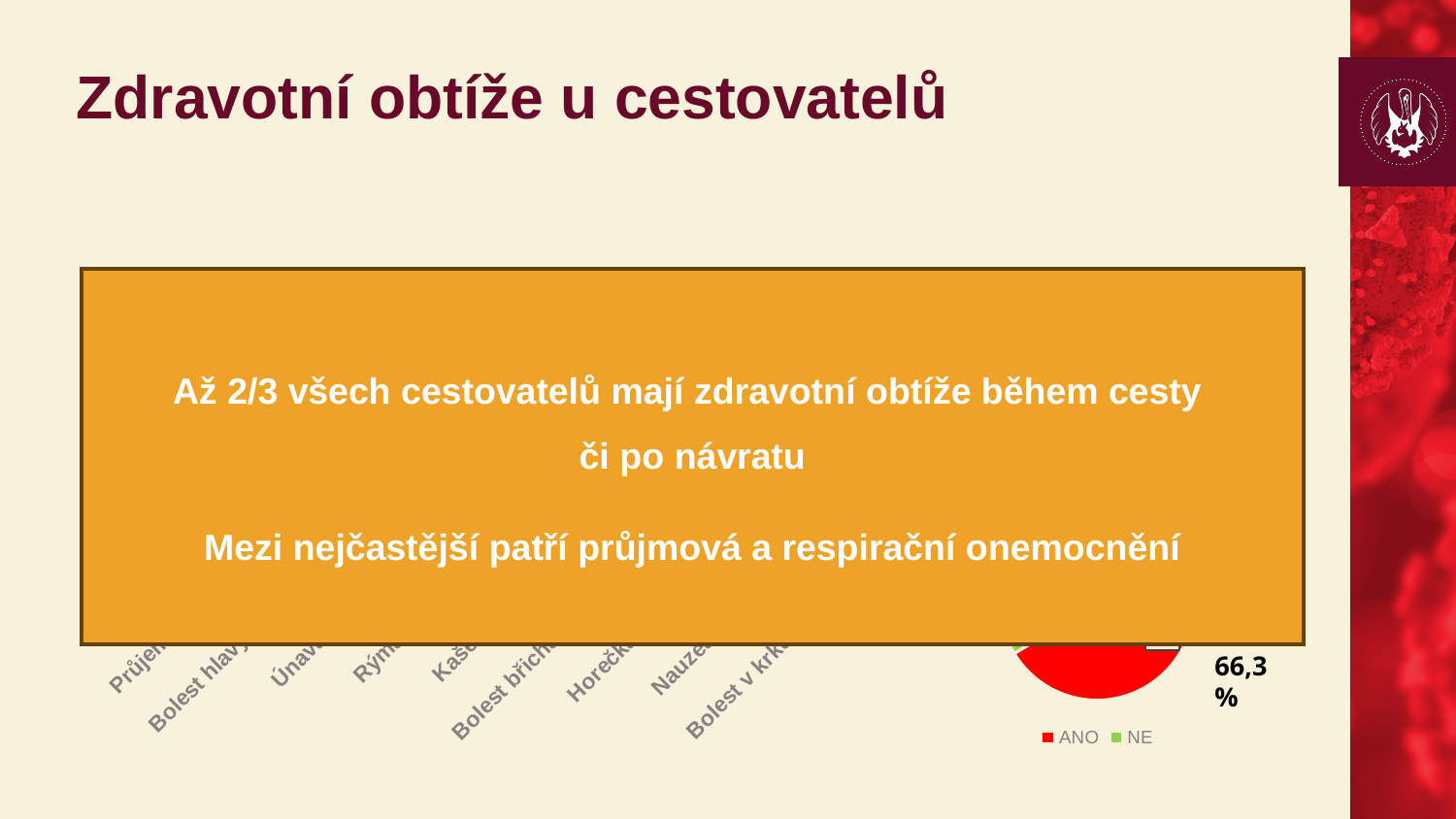
On the chart at the bottom right of the slide, what value is printed as a data label? 66,3 % What kind of chart is shown at the bottom right of the slide? Pie chart On the chart at the bottom left of the slide, what is the first category label on the x axis? Průjem On the chart at the bottom right of the slide, what colour represents ANO in the legend? Red On the chart at the bottom right of the slide, how many entries does the legend list? 2 On the chart at the bottom right of the slide, what are the legend entries? ANO, NE On the chart at the bottom left of the slide, how many category labels are shown along the x axis? 9